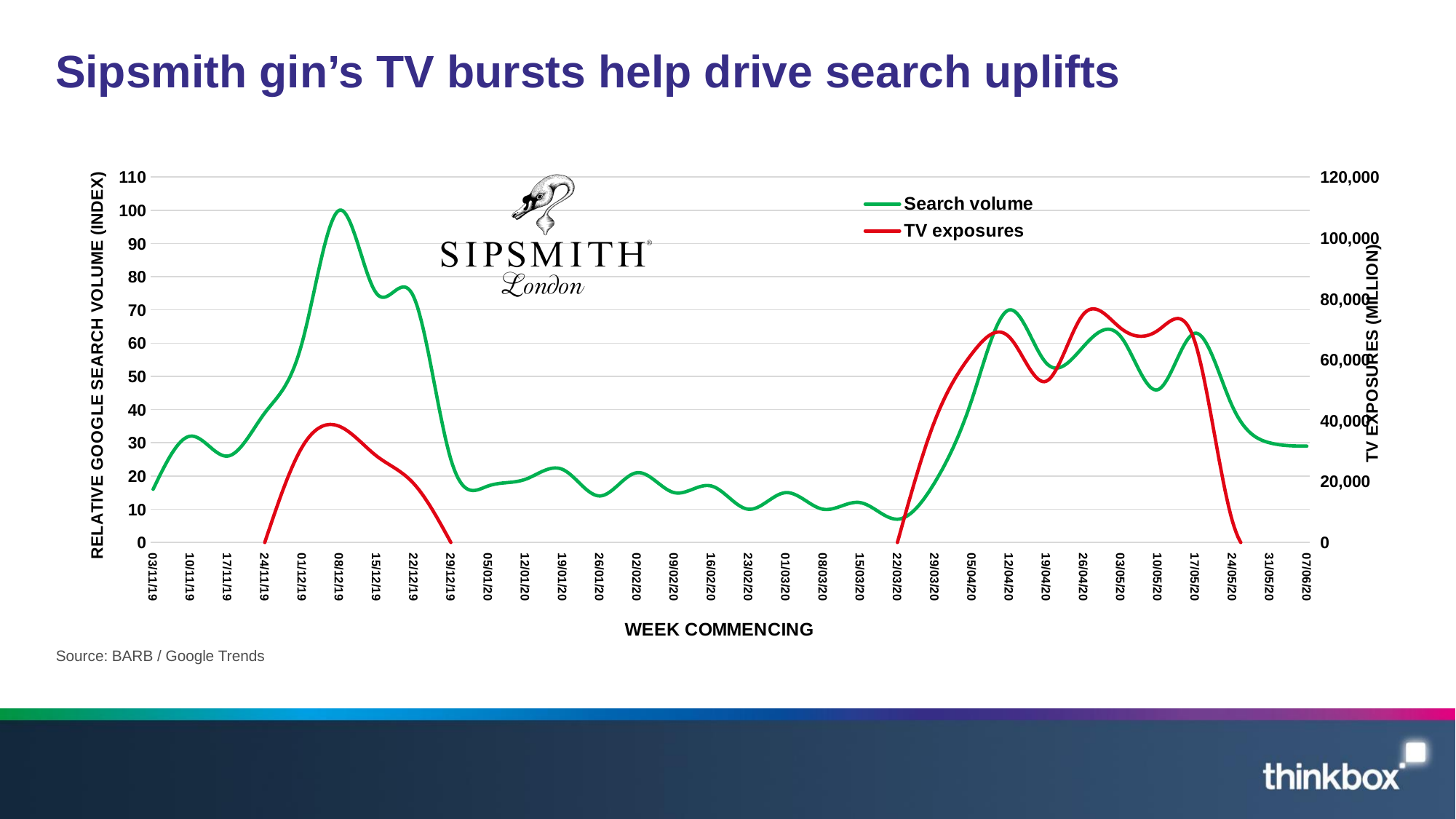
Is the TV exposures value for the week commencing 08/12/19 greater or less than 60,000? less What kind of chart is shown on the slide? Line chart Is the TV exposures value for the week commencing 26/04/20 greater or less than 60,000? greater What is the TV exposures value for the week commencing 29/12/19? 0 How many series does the legend list? 2 How many weeks are shown on the x axis? 32 Is the Search volume for the week commencing 03/11/19 greater or less than 20? less Does Search volume rise or fall between the weeks commencing 08/12/19 and 29/12/19? Fall Which week has the higher Search volume, 08/12/19 or 12/04/20? 08/12/19 What is the Search volume index for the week commencing 08/12/19? 100 In which week does Search volume reach its highest value? 08/12/19